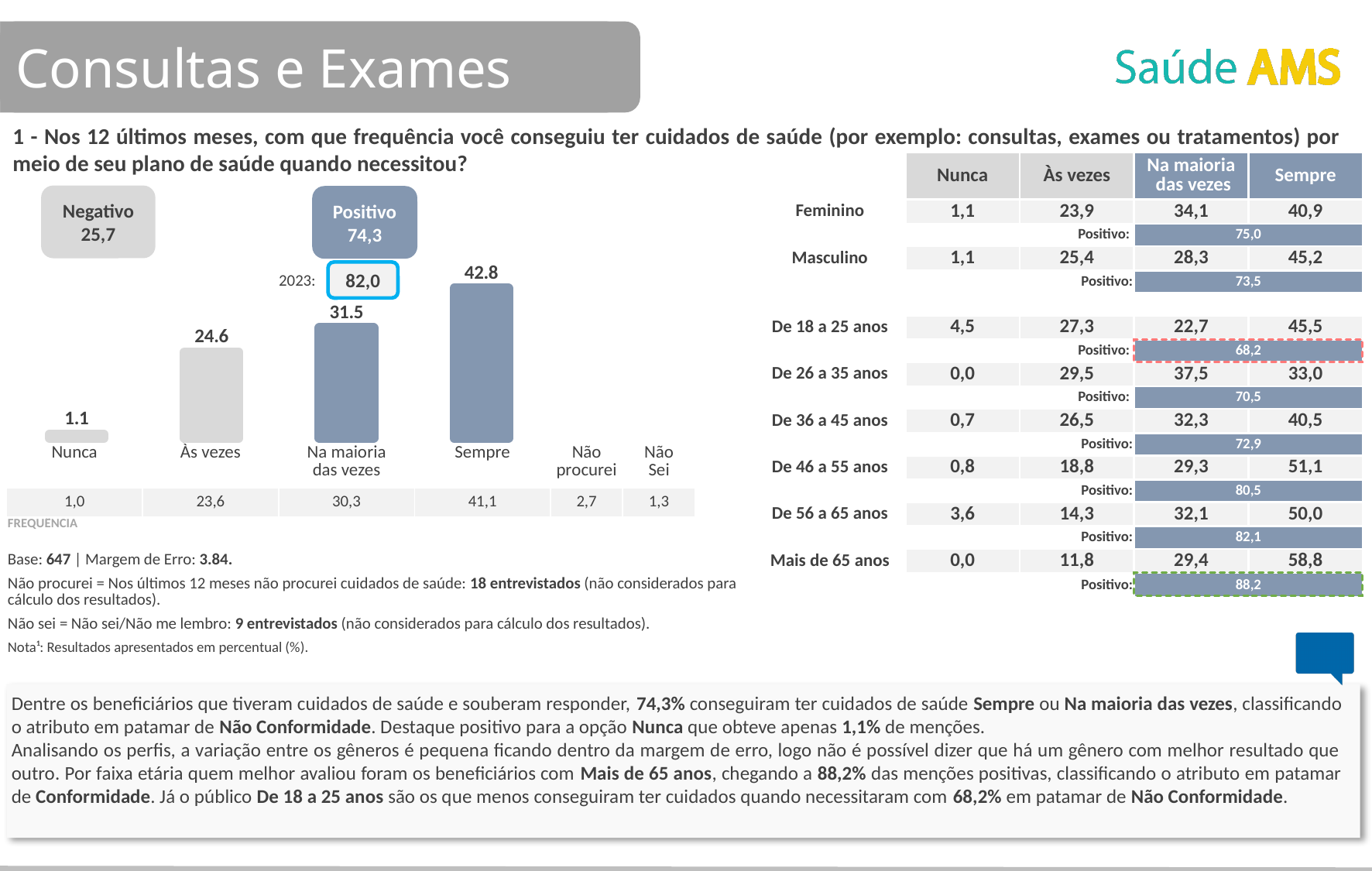
What type of chart is used to show the frequency responses on the slide? Bar chart What value is shown in the "Negativo" box above the bar chart? 25,7 What is the value of the bar for "Sempre" in the bar chart? 42.8 What is the combined value of the "Na maioria das vezes" and "Sempre" bars in the bar chart? 74.3 What is the value of the bar for "Nunca" in the bar chart? 1.1 Which bar is larger in the bar chart, "Às vezes" or "Na maioria das vezes"? Na maioria das vezes What is the value of the bar for "Na maioria das vezes" in the bar chart? 31.5 Which category has the highest bar in the bar chart? Sempre Which category has the lowest bar in the bar chart? Nunca What is the difference between the bars for "Sempre" and "Na maioria das vezes" in the bar chart? 11.3 What value is shown in the highlighted "2023:" box above the bar chart? 82,0 What is the value of the bar for "Às vezes" in the bar chart? 24.6